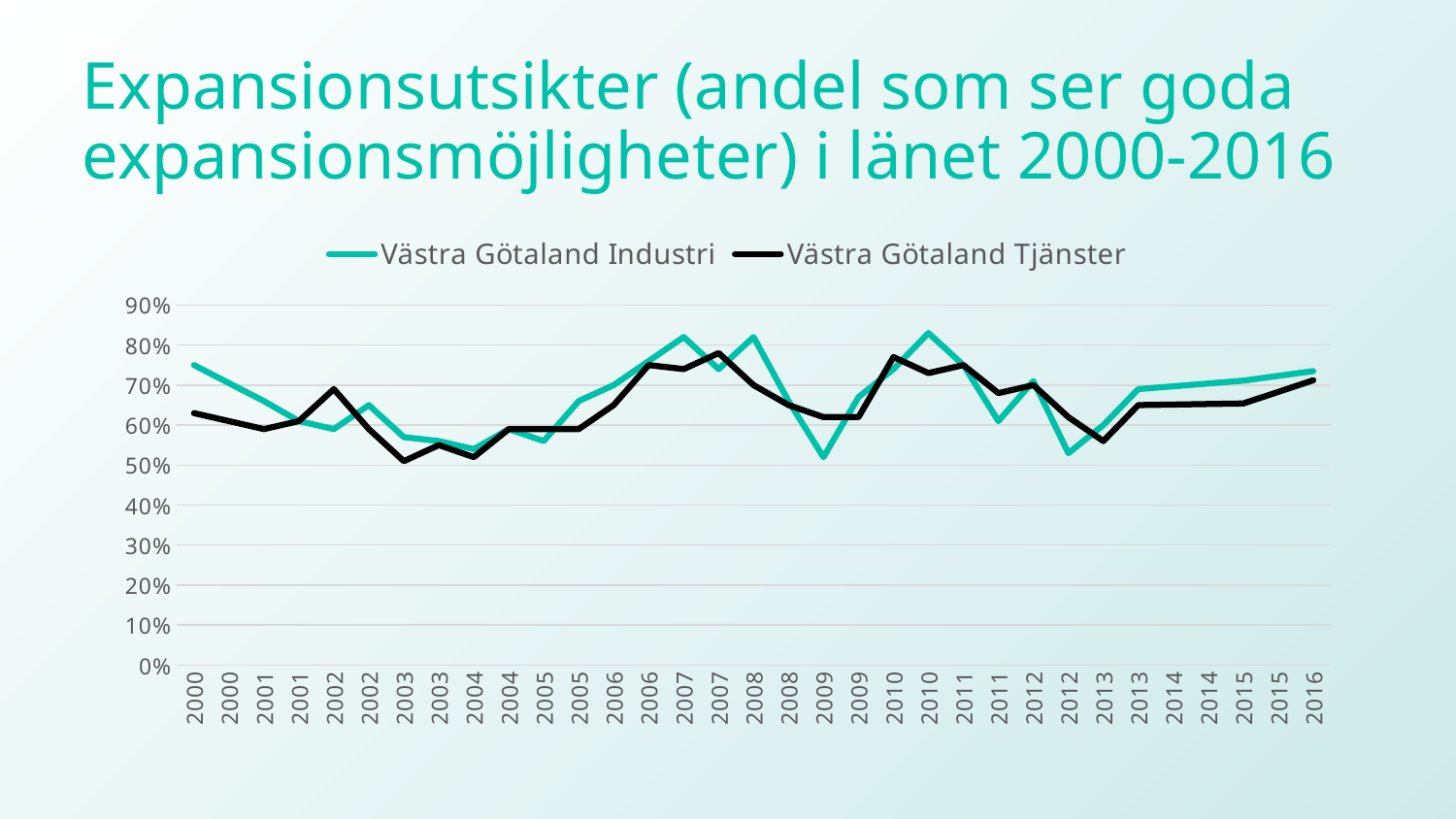
At the first 2000 point, which series has the higher value, Västra Götaland Industri or Västra Götaland Tjänster? Västra Götaland Industri Does the Västra Götaland Industri line rise or fall from the second 2012 point to 2016? rise What are the two series named in the legend? Västra Götaland Industri and Västra Götaland Tjänster Is the value for Västra Götaland Industri at the first 2000 point greater or less than 70%? greater What kind of chart is shown on the slide? line chart Is the value for Västra Götaland Tjänster at the first 2003 point greater or less than 60%? less Is the value for Västra Götaland Industri at the second 2012 point greater or less than 60%? less How many series does the legend list? 2 Which colour is used for the Västra Götaland Tjänster line? black At the first 2009 point, which series has the higher value, Västra Götaland Industri or Västra Götaland Tjänster? Västra Götaland Tjänster